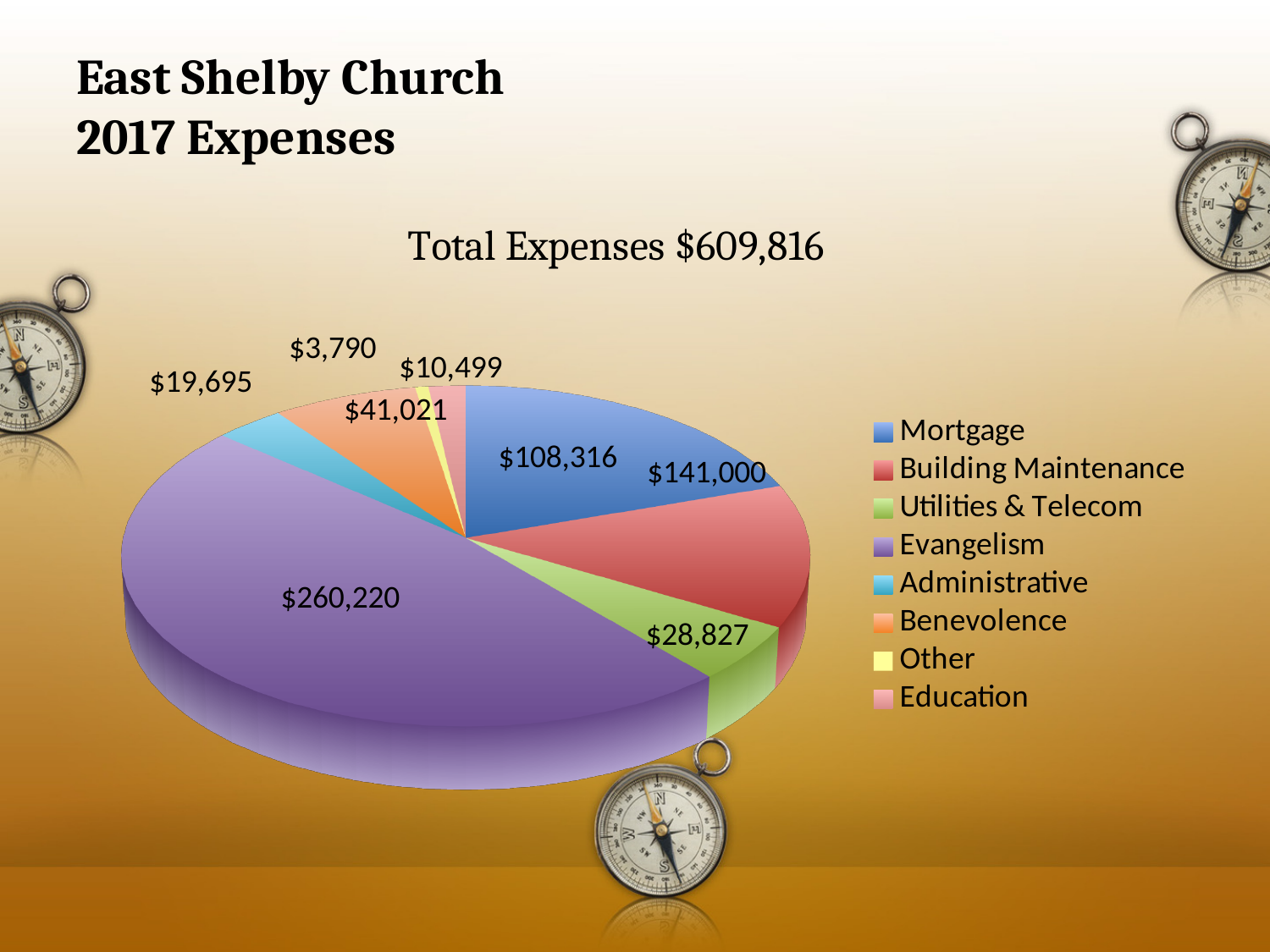
What is the value of the Evangelism slice? $260,220 Which is larger, Benevolence or Administrative? Benevolence What is the value of the Other slice? $3,790 Which category has the largest expense? Evangelism What is the difference between the Evangelism and Mortgage expenses? $151,904 What total expenses figure is printed above the chart? $609,816 What is the value of the Mortgage slice? $108,316 What type of chart is shown on the slide? Pie chart What is the value of the Benevolence slice? $41,021 How many categories does the legend list? 8 Which category has the smallest expense? Other What is the value of the Administrative slice? $19,695